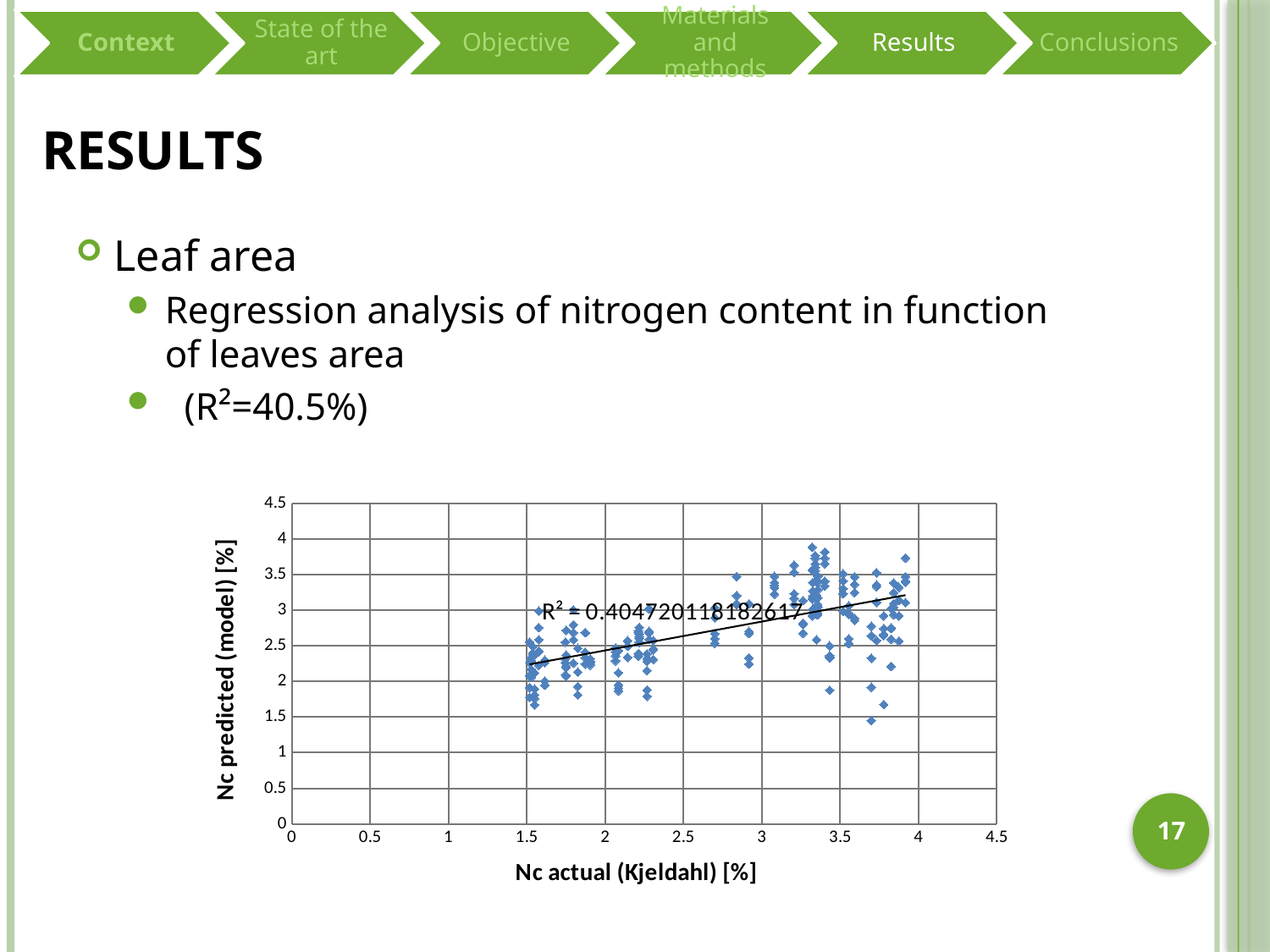
What R² value is printed on the chart? R² = 0.404720118182617 What is the title of the x axis of the chart? Nc actual (Kjeldahl) [%] Does the fitted trendline on the chart slope upward or downward from left to right? upward Do the plotted values of Nc predicted (model) tend to rise or fall as Nc actual (Kjeldahl) increases? rise What kind of chart is shown on the slide? scatter chart What is the highest tick value shown on the x axis of the chart? 4.5 What is the highest tick value shown on the y axis of the chart? 4.5